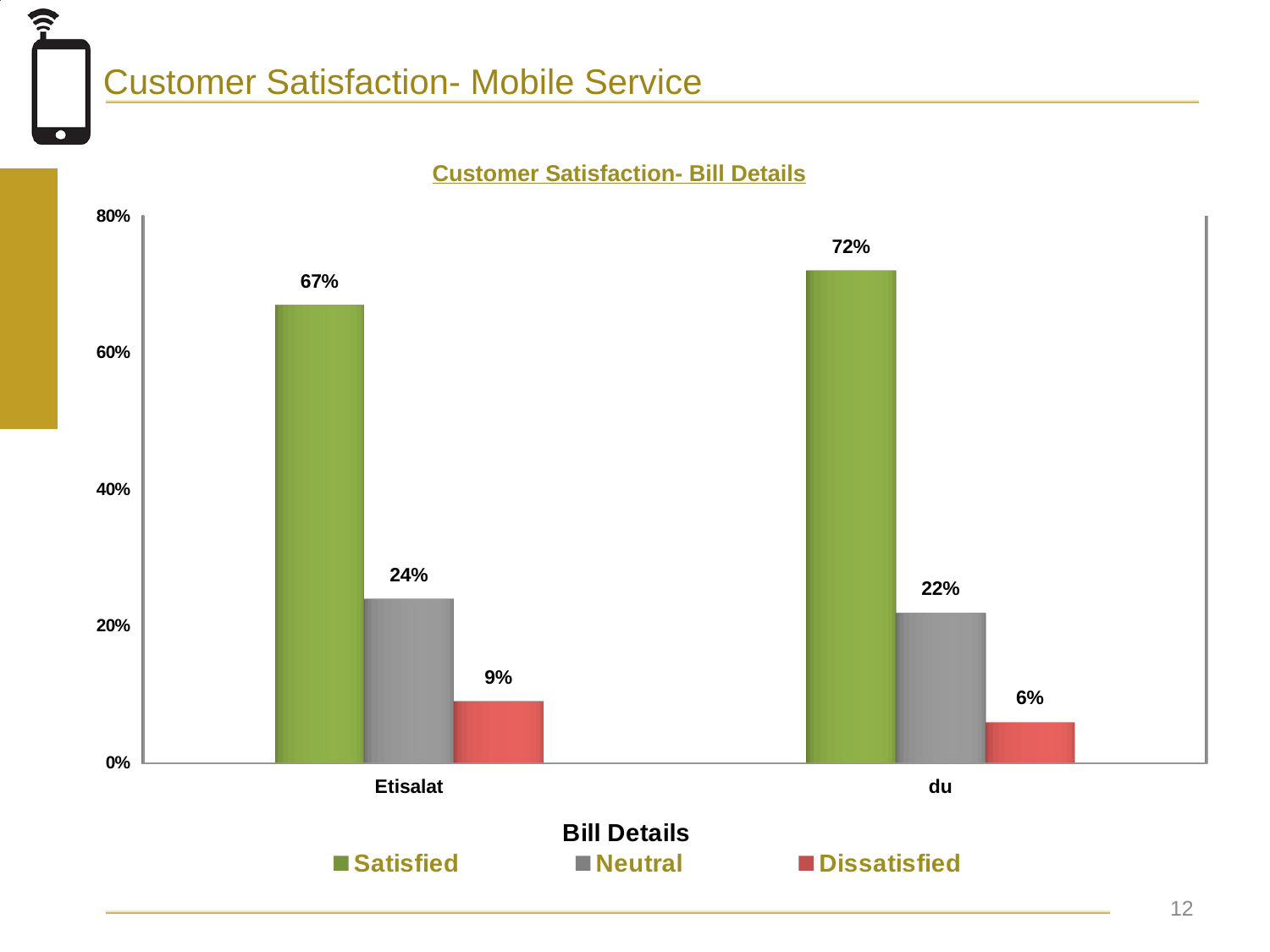
How many series does the legend list? 3 What is the difference between the Neutral percentages for Etisalat and du? 2% What percentage of Etisalat customers are Satisfied with bill details? 67% What is the Dissatisfied value for Etisalat? 9% Which provider has the lower Dissatisfied percentage? du What is the Dissatisfied value for du? 6% What is the difference between the Satisfied percentages for du and Etisalat? 5% What type of chart is shown on the slide? Bar chart Which provider has the higher Satisfied percentage? du How many providers are shown on the x axis? 2 What percentage of du customers are Neutral about bill details? 22% Is the Neutral value for Etisalat greater or less than 20%? greater